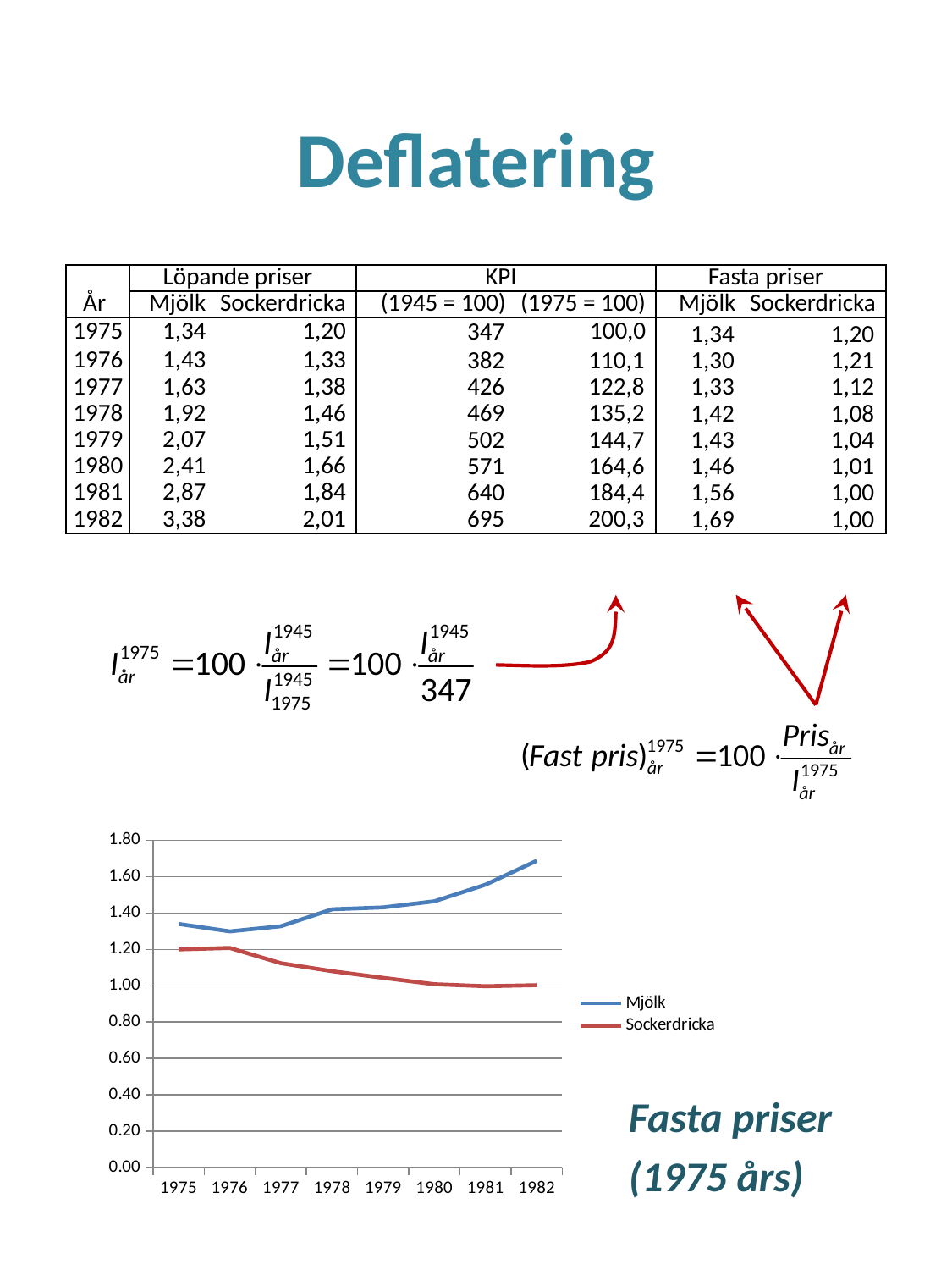
Does the Mjölk line rise or fall overall from 1975 to 1982? rise In 1982, which series has the higher value, Mjölk or Sockerdricka? Mjölk Is the value for Mjölk in 1975 greater or less than 1.20? greater Is the value for Mjölk in 1982 greater or less than 1.60? greater How many series does the chart's legend list? 2 In which year is the Mjölk line at its highest? 1982 Which series is drawn in red on the chart? Sockerdricka What kind of chart is shown at the bottom of the slide? line chart Is the value for Sockerdricka in 1980 greater or less than 1.20? less How many years are shown on the x axis of the chart? 8 Does the Sockerdricka line rise or fall overall from 1975 to 1982? fall Which two series are listed in the chart's legend? Mjölk and Sockerdricka